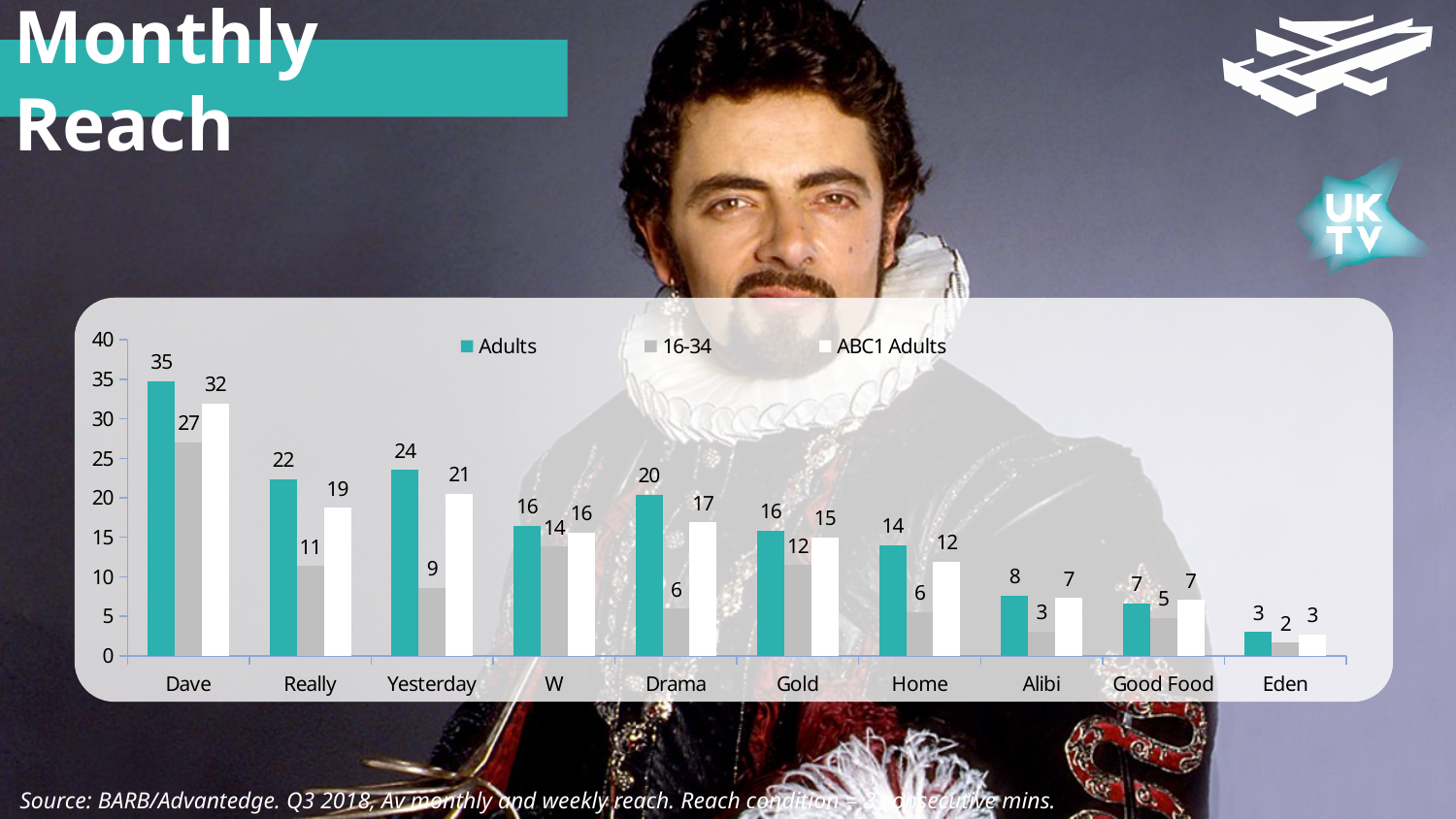
Which channel has the highest Adults value? Dave What is the difference between the Adults value and the 16-34 value for Really? 11 Which channel has the lowest 16-34 value? Eden What is the Adults value for Dave? 35 How many series does the legend list? 3 What kind of chart is shown on the slide? Bar chart How many channels are shown on the x axis? 10 What is the ABC1 Adults value for Drama? 17 What is the title of the slide containing the chart? Monthly Reach Which is larger, the ABC1 Adults value for Yesterday or the ABC1 Adults value for Really? Yesterday Do the Adults values generally rise or fall from Dave to Eden along the x axis? Fall What is the 16-34 value for Yesterday? 9